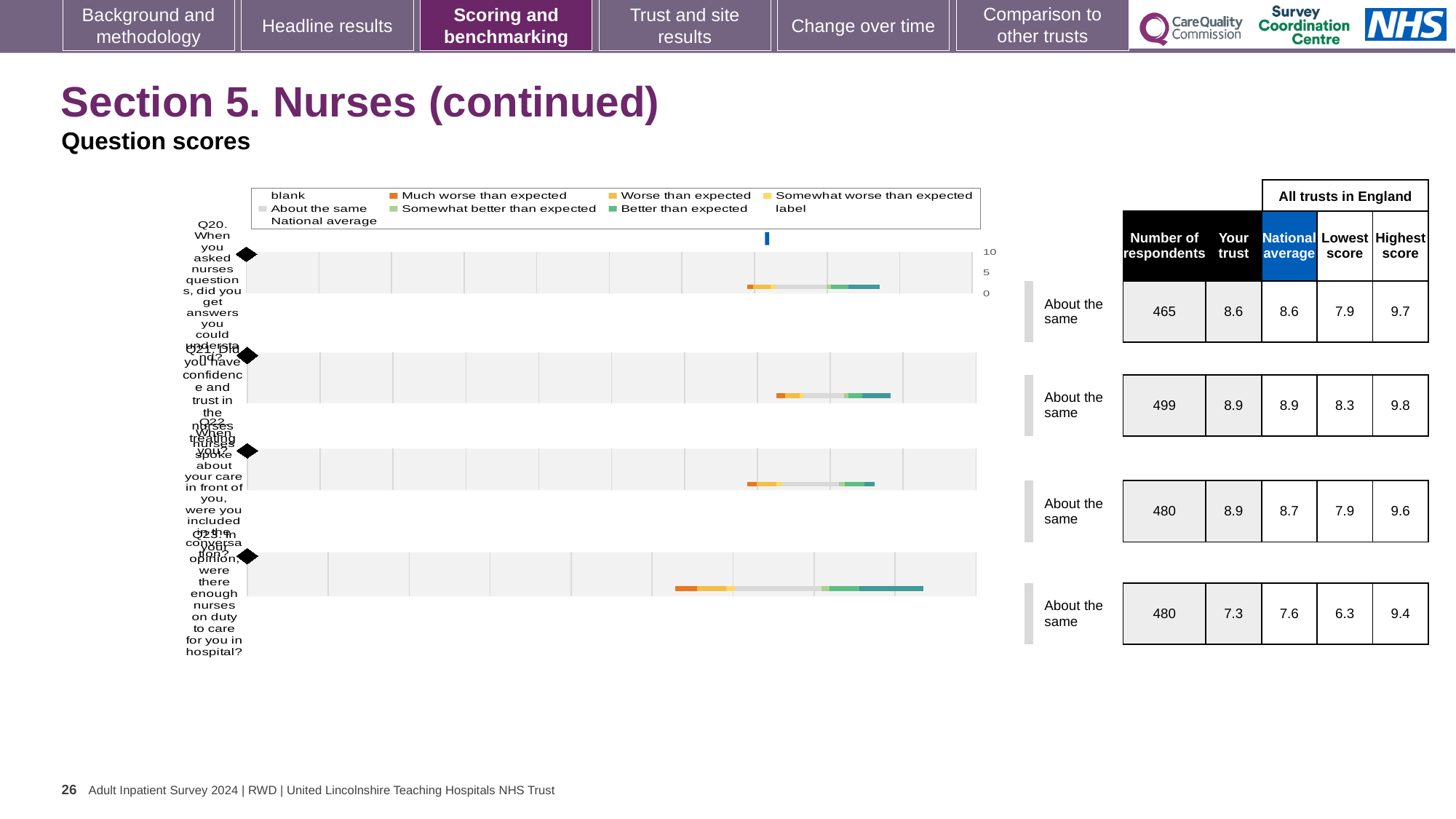
How many entries does the chart's legend list? 9 Which question number in the chart asks whether there were enough nurses on duty to care for you in hospital? Q23 In the table beside the chart, is the 'Your trust' score for Q22 larger or smaller than the national average for Q22? larger How many questions (categories) are plotted in the chart? 4 In the table beside the chart, what is the highest score across all trusts in England for Q21? 9.8 In the table beside the chart, what is the difference between the highest score and the lowest score for Q23? 3.1 In the table beside the chart, what is the 'Your trust' score for Q23? 7.3 In the table beside the chart, what is the national average for Q22? 8.7 In the table beside the chart, what is the number of respondents for Q21? 499 In the table beside the chart, which question has the lowest 'Your trust' score? Q23 What kind of chart is shown on the slide? bar chart What colour does the legend use for 'Much worse than expected'? orange